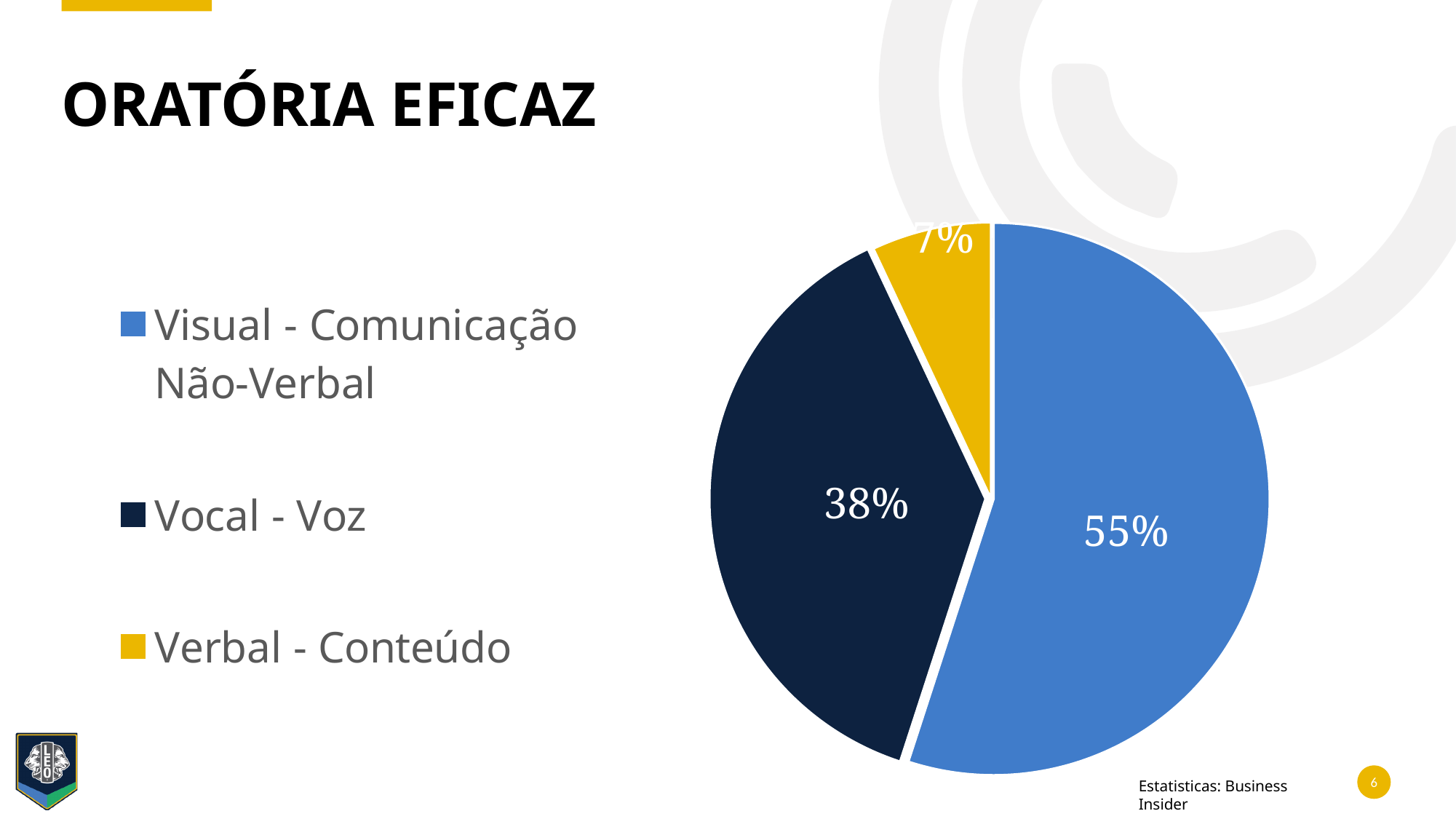
How many slices does the pie chart have? 3 How many entries does the legend list? 3 What is the difference between the Visual - Comunicação Não-Verbal and Vocal - Voz values? 17% Which is larger, Vocal - Voz or Verbal - Conteúdo? Vocal - Voz Which category has the largest slice? Visual - Comunicação Não-Verbal What is the difference between the Vocal - Voz and Verbal - Conteúdo values? 31% Which category has the smallest slice? Verbal - Conteúdo What is the value for Vocal - Voz? 38% What colour is the Verbal - Conteúdo slice? yellow What is the value for Visual - Comunicação Não-Verbal? 55% What kind of chart is shown on the slide? pie chart What is the value for Verbal - Conteúdo? 7%